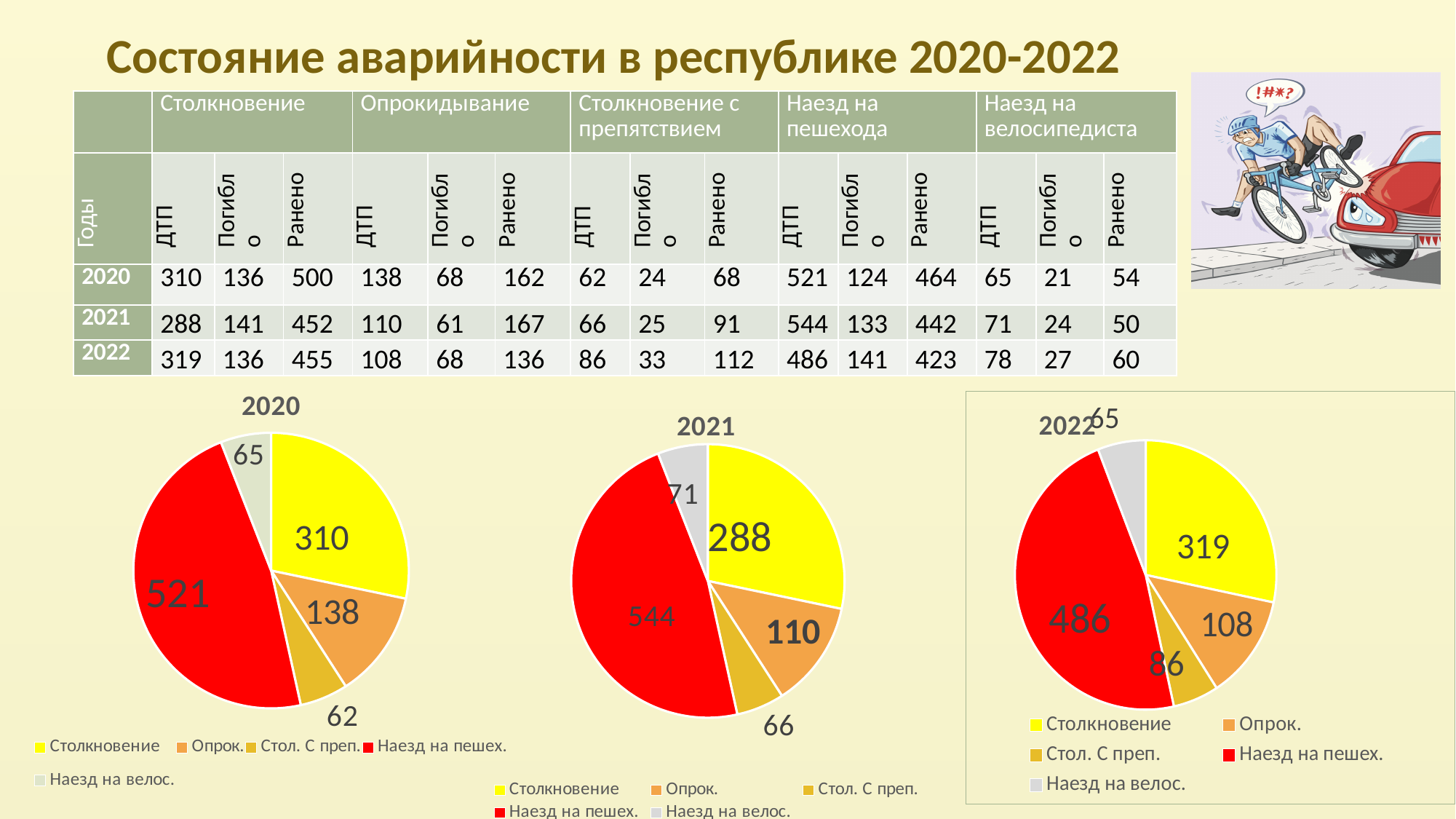
In the 2022 pie chart, what is the value for Опрок.? 108 In the 2021 pie chart, what is the difference between Наезд на пешех. and Столкновение? 256 In the 2022 pie chart, which is larger: Стол. С преп. or Опрок.? Опрок. In the 2021 pie chart, what is the value for Столкновение? 288 What type of chart is used for the 2020 data? Pie chart How many entries does the legend of the 2022 pie chart list? 5 In the 2020 pie chart, what is the value for Наезд на пешех.? 521 In the 2021 pie chart, which colour represents Наезд на пешех.? Red In the 2020 pie chart, which category has the smallest slice? Стол. С преп. In the 2022 pie chart, which category has the largest slice? Наезд на пешех. In the 2020 pie chart, what is the total of all slices? 1096 How many slices does the 2021 pie chart have? 5